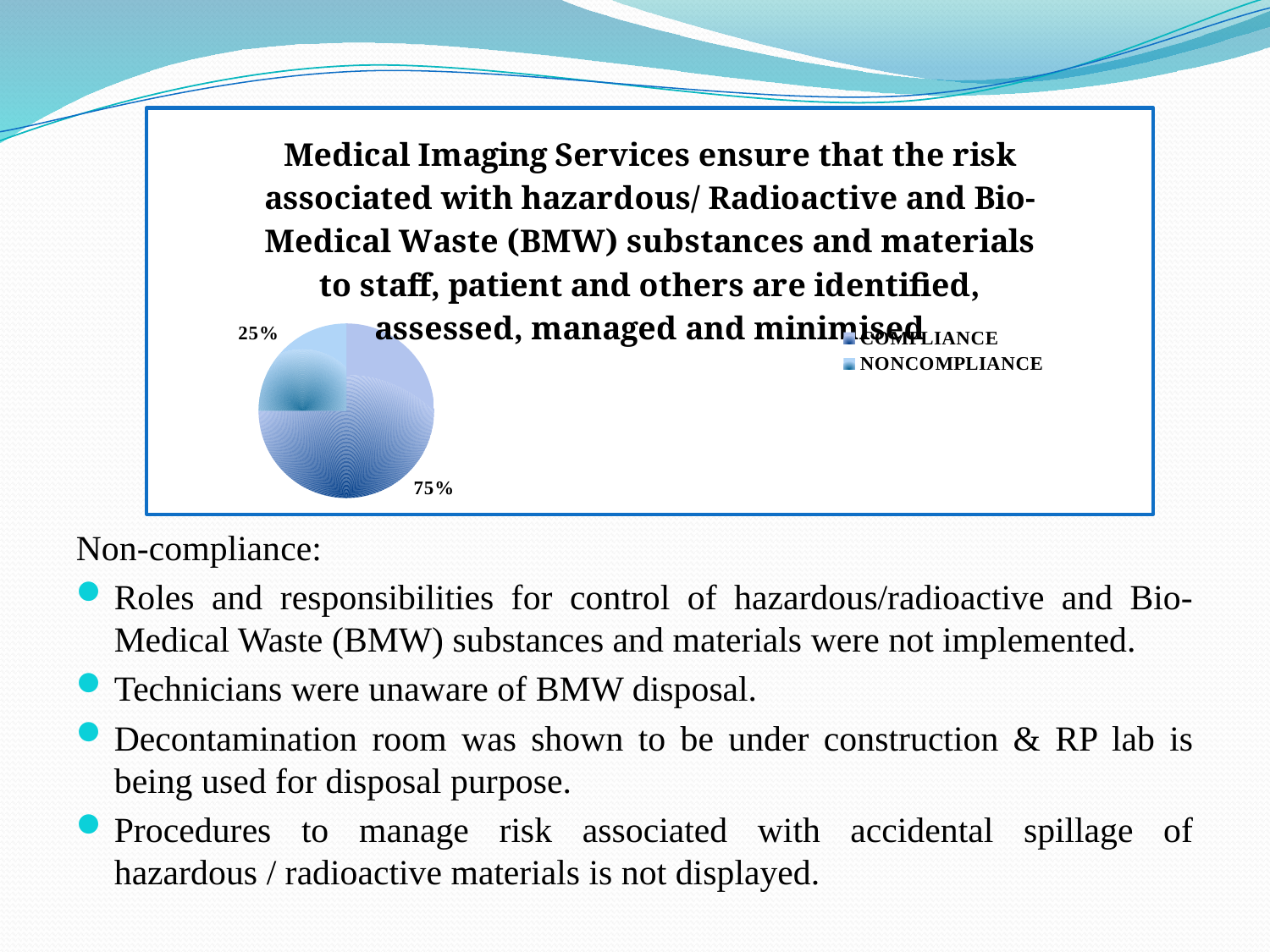
What type of chart is shown on the slide? pie chart What percentage is shown for the larger slice of the pie chart? 75% How many slices does the pie chart have? 2 What share of the pie does COMPLIANCE represent? 75% What is the difference between the two slice percentages in the pie chart? 50% What are the two legend entries of the pie chart? COMPLIANCE and NONCOMPLIANCE How many entries does the legend of the pie chart list? 2 What percentage is shown for the smaller slice of the pie chart? 25% What do the two slice percentages in the pie chart add up to? 100% Is the NONCOMPLIANCE share greater or less than 50%? less What share of the pie does NONCOMPLIANCE represent? 25% Which is larger in the pie chart, COMPLIANCE or NONCOMPLIANCE? COMPLIANCE